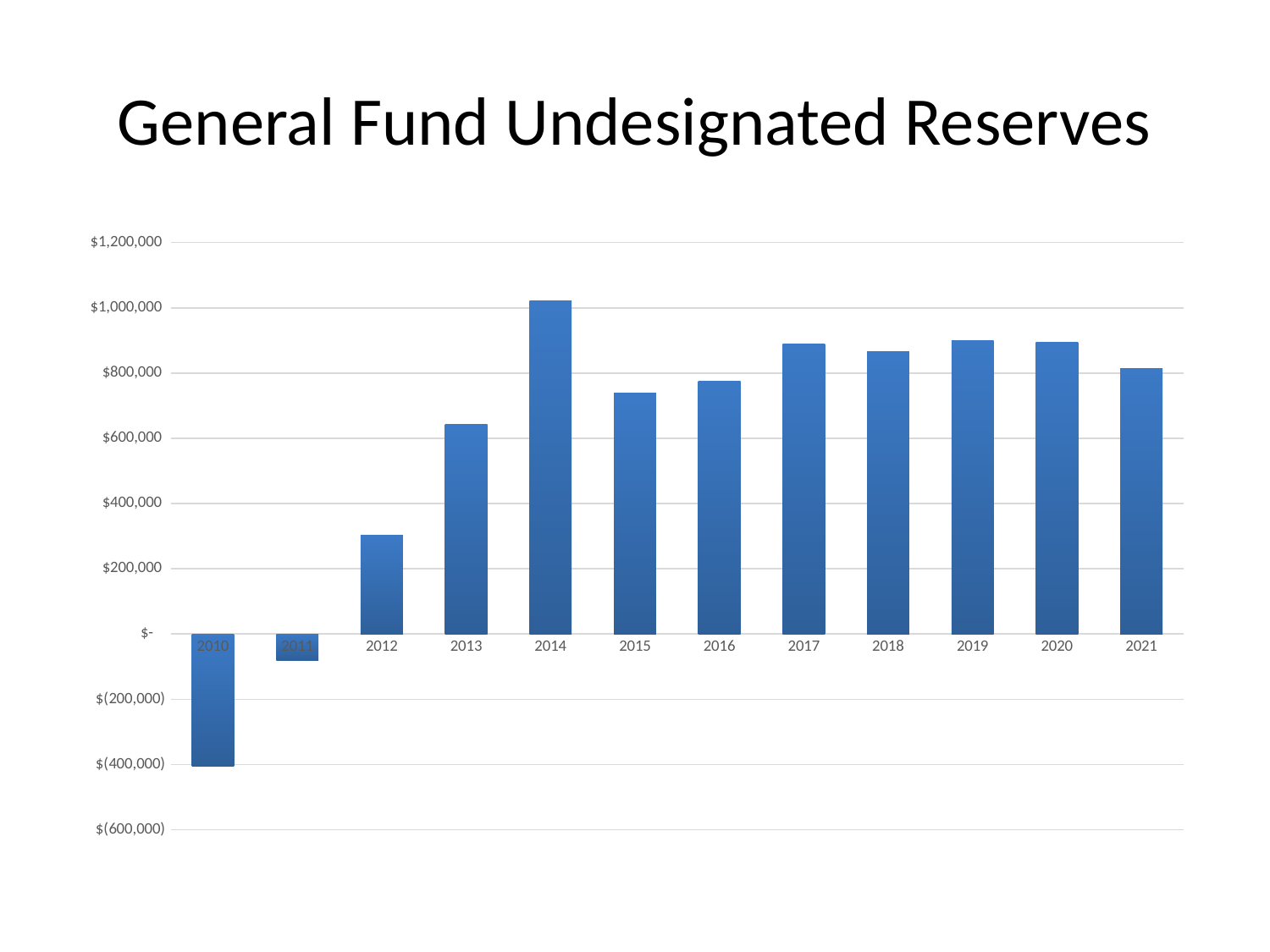
Is the value for 2015 greater or less than $800,000? less Is the value for 2014 greater or less than $1,000,000? greater Which is larger, the value for 2013 or the value for 2012? 2013 What kind of chart is shown on the slide? bar chart How many years show a negative value? 2 How many years are plotted on the x axis? 12 Is the value for 2010 greater or less than $(200,000)? less What is the title of the chart? General Fund Undesignated Reserves Which year has the highest General Fund Undesignated Reserves? 2014 Which year has the lowest General Fund Undesignated Reserves? 2010 Which is larger, the value for 2020 or the value for 2021? 2020